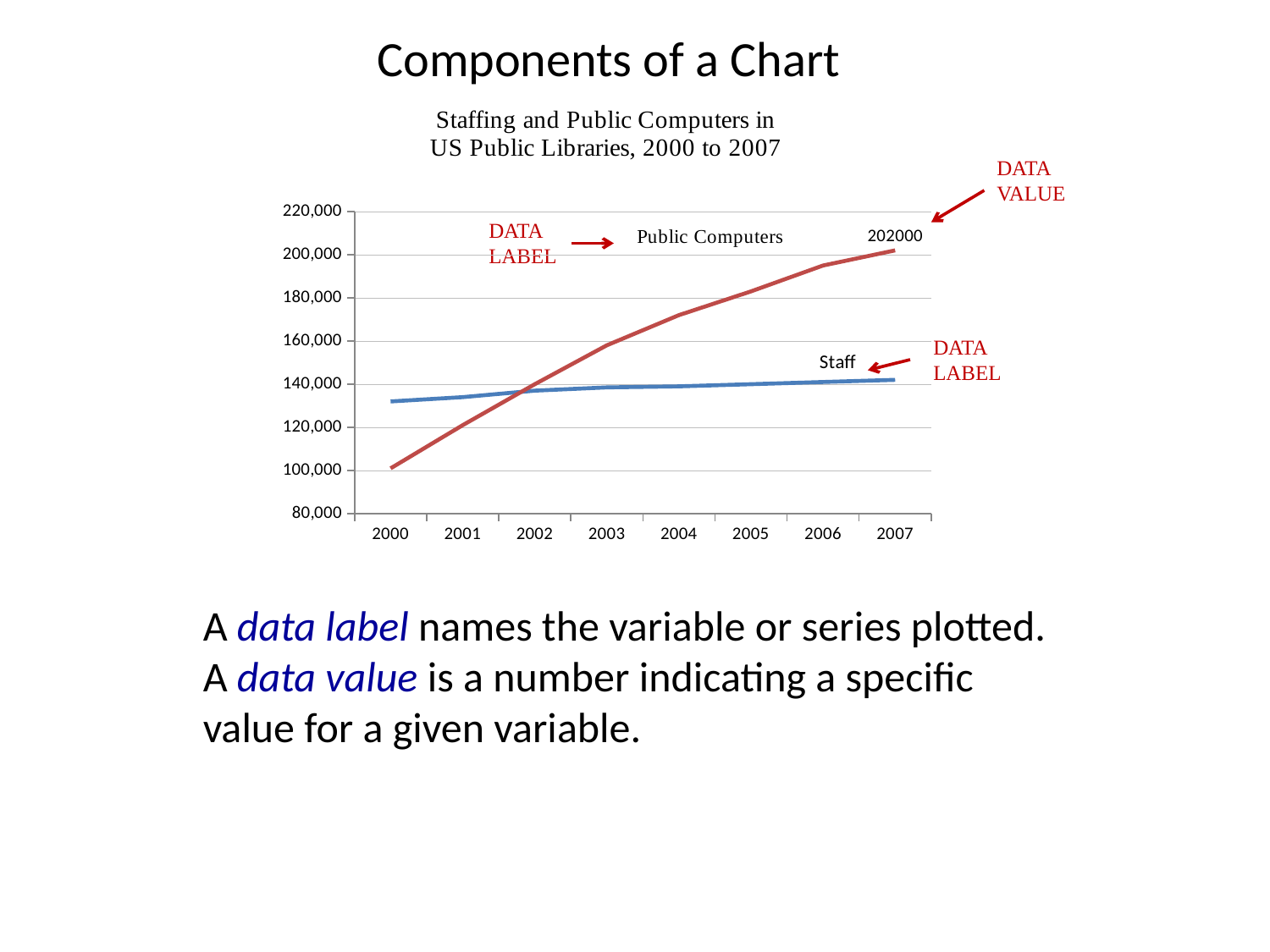
What is the value of Public Computers in 2007? 202000 What is the title of the chart? Staffing and Public Computers in US Public Libraries, 2000 to 2007 Is the value for Public Computers in 2000 greater or less than 120,000? less In 2000, which series has the larger value, Staff or Public Computers? Staff Is the value for Public Computers in 2004 greater or less than 160,000? greater In 2007, which series has the larger value, Public Computers or Staff? Public Computers Is the value for Staff in 2007 greater or less than 160,000? less How many series are plotted on the chart? 2 How many years are plotted along the x axis? 8 In which year is the Public Computers value highest? 2007 Does the Public Computers line rise or fall from 2000 to 2007? rise What kind of chart is shown on the slide? line chart